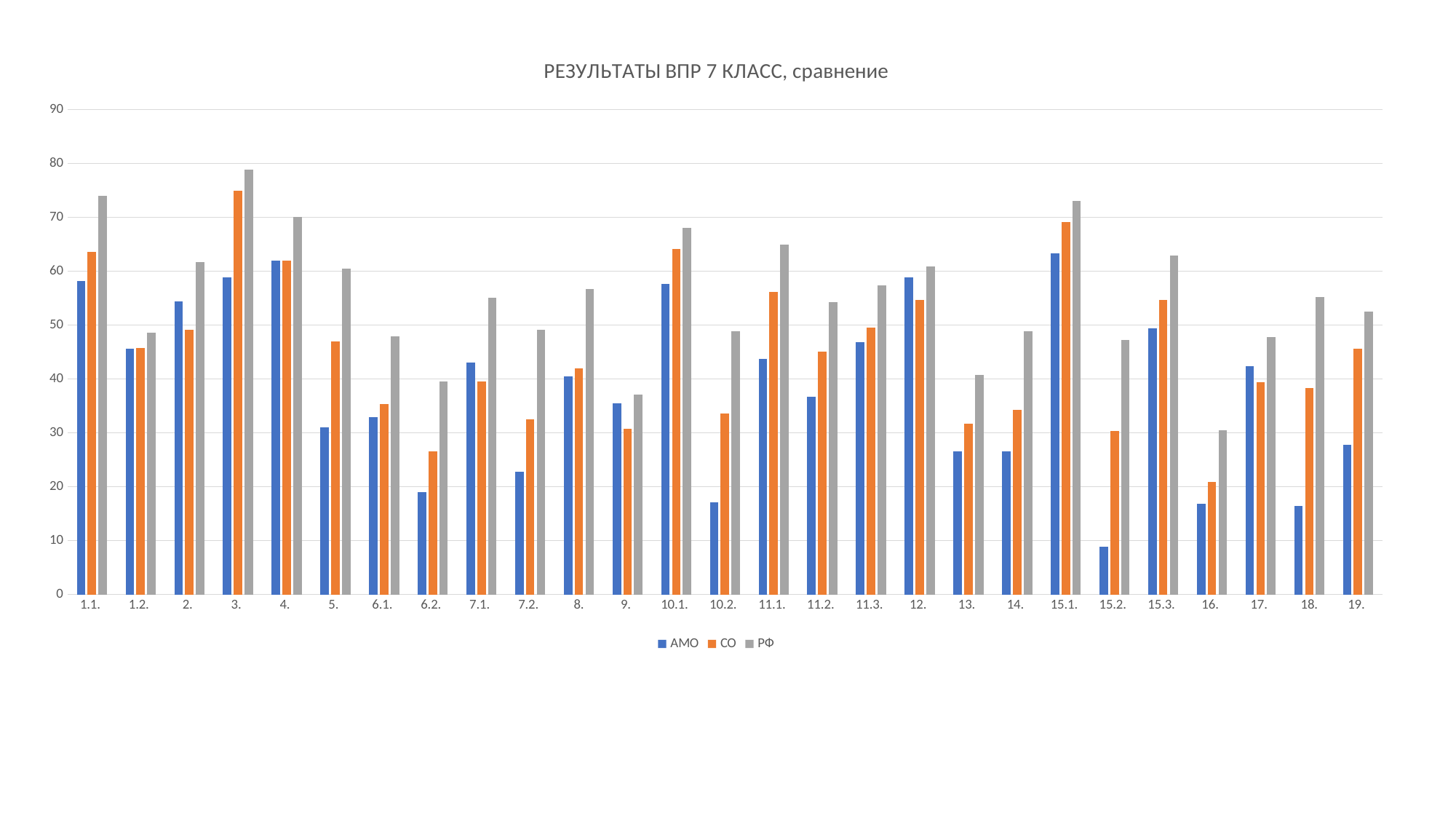
How many series does the legend list? 3 What is the title of the chart? РЕЗУЛЬТАТЫ ВПР 7 КЛАСС, сравнение How many categories are shown along the x axis? 27 Is the value for АМО at category 15.2. greater or less than 10? less At category 9., which is larger, АМО or СО? АМО Which category has the highest value for the РФ series? 3. Is the value for РФ at category 3. greater or less than 70? greater Which category has the highest value for the СО series? 3. At category 16., which is larger, АМО or РФ? РФ What kind of chart is shown on the slide? bar chart Which category has the lowest value for the АМО series? 15.2.